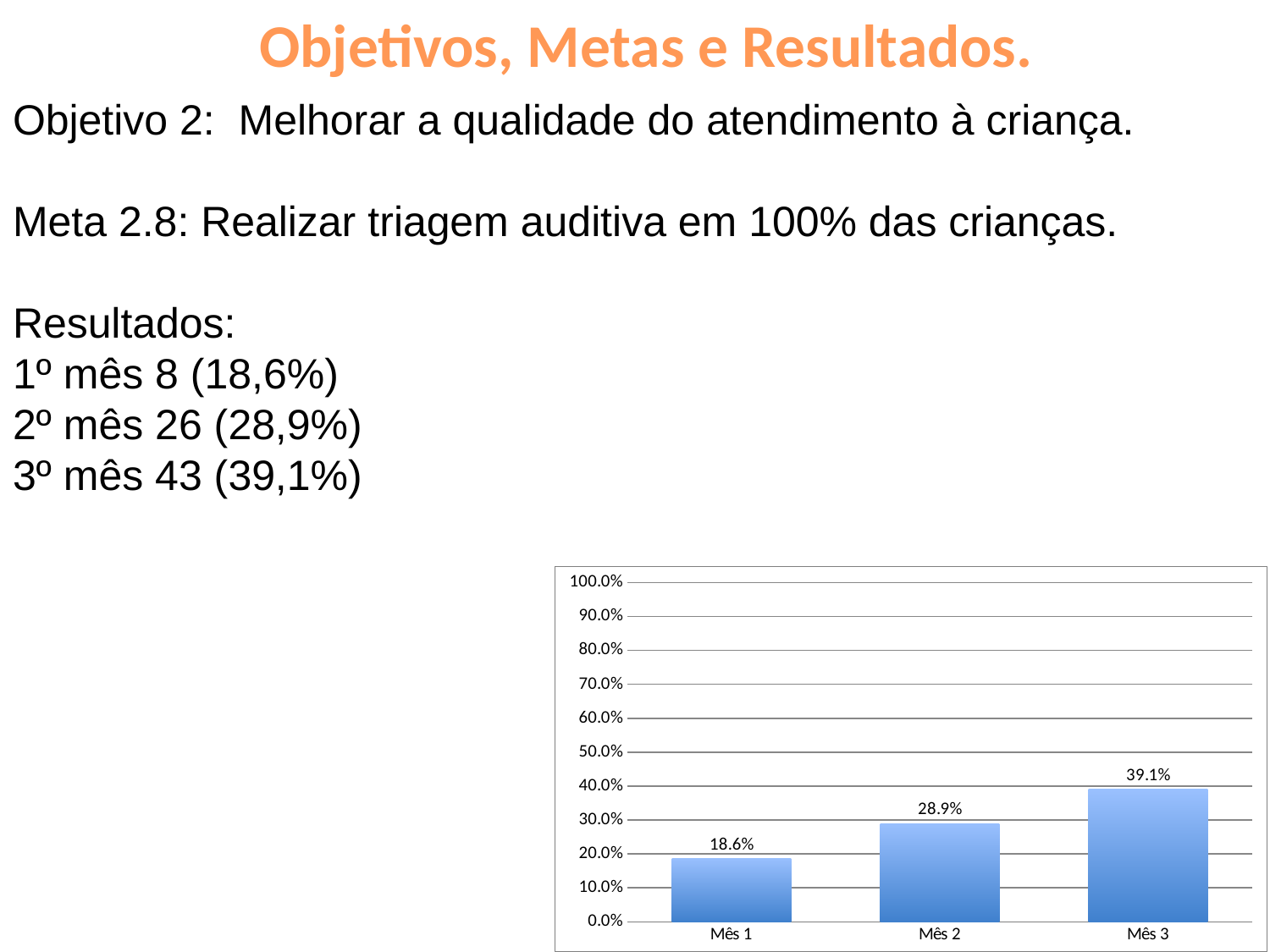
What is the difference between the values for Mês 3 and Mês 1? 20.5% What is the value for Mês 1? 18.6% Is the value for Mês 3 greater or less than 50.0%? less Which month has the lowest value? Mês 1 Which month has the highest value? Mês 3 What is the value for Mês 2? 28.9% What is the value for Mês 3? 39.1% Which is larger, the value for Mês 2 or the value for Mês 3? Mês 3 Do the values rise or fall from Mês 1 to Mês 3? rise How many categories are shown on the x axis? 3 What is the difference between the values for Mês 2 and Mês 1? 10.3% What kind of chart is shown on the slide? bar chart